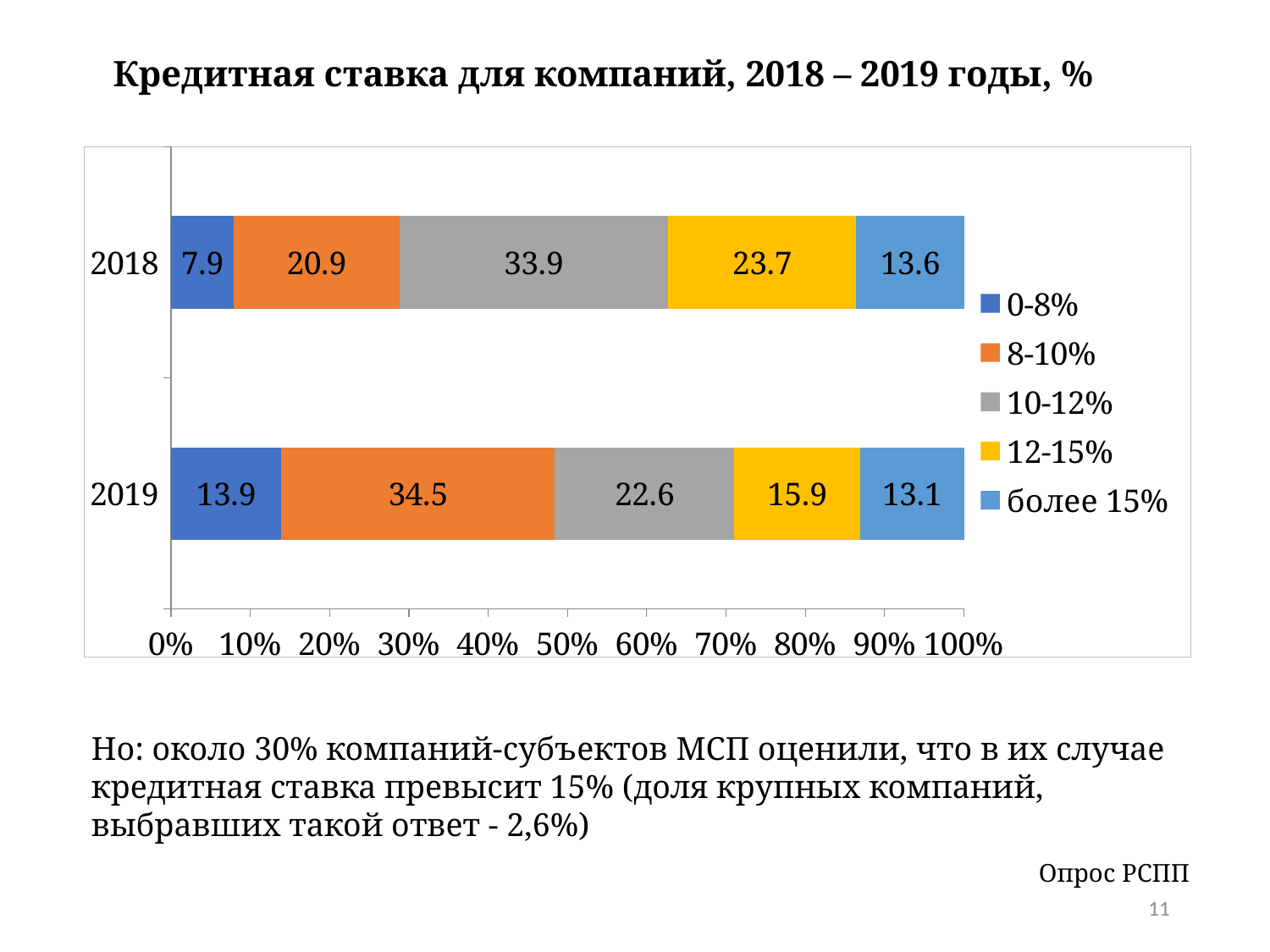
How many series does the legend list? 5 What is the value for the более 15% series in 2019? 13.1 Which is larger: the 12-15% value in 2018 or in 2019? 2018 Which series has the largest value in the 2018 bar? 10-12% What is the value for the 10-12% series in 2018? 33.9 Which series has the largest value in the 2019 bar? 8-10% How many categories (years) are shown on the chart? 2 What kind of chart is shown on the slide? Stacked bar chart What is the value for the 8-10% series in 2019? 34.5 What is the difference between the 8-10% values for 2019 and 2018? 13.6 Which series has the smallest value in the 2018 bar? 0-8% What is the total of the 2019 stacked bar? 100